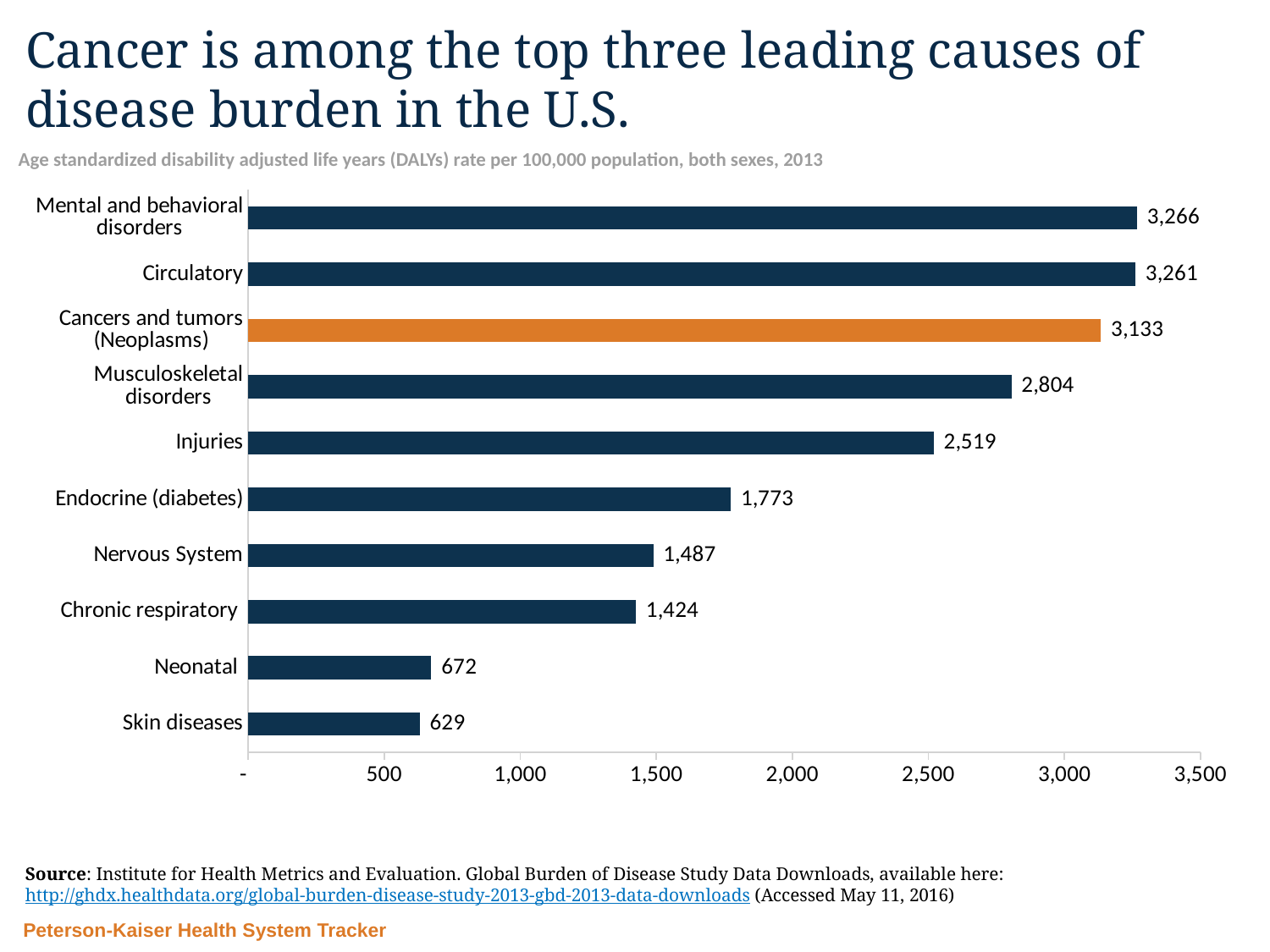
What kind of chart is shown on the slide? bar chart What is the difference between the values for Neonatal and Skin diseases? 43 What is the value shown for Chronic respiratory? 1,424 What is the value shown for Injuries? 2,519 How many categories are shown in the chart? 10 Which category has the lowest DALY rate? Skin diseases Which category's bar is highlighted in orange? Cancers and tumors (Neoplasms) Which category has the highest DALY rate? Mental and behavioral disorders What is the difference between the values for Cancers and tumors (Neoplasms) and Musculoskeletal disorders? 329 Is the value for Musculoskeletal disorders greater or less than 3,000? less Which is larger, the value for Endocrine (diabetes) or the value for Nervous System? Endocrine (diabetes) What is the DALY rate for Cancers and tumors (Neoplasms)? 3,133